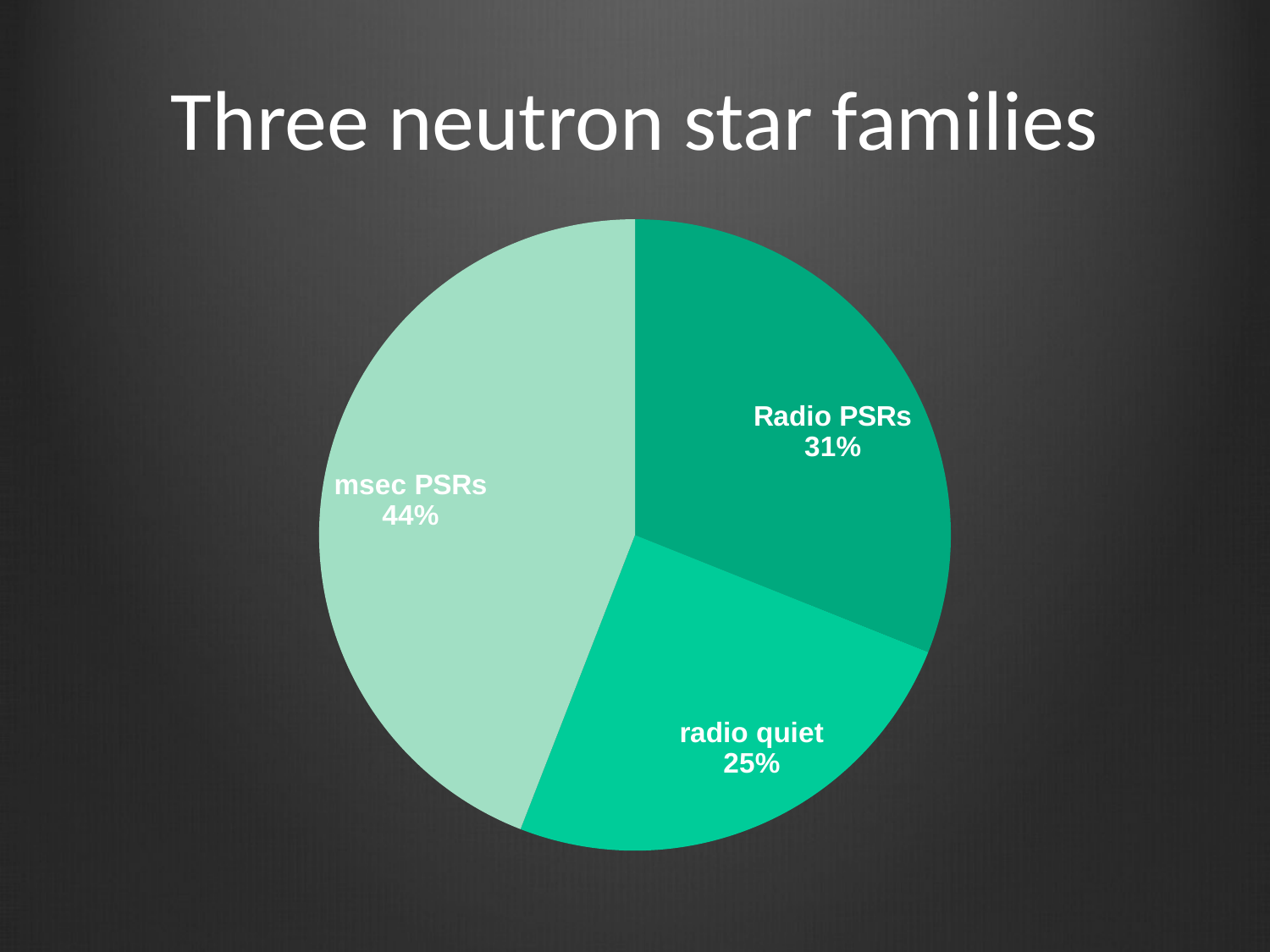
What share of the pie is labelled for radio quiet? 25% What is the difference in percentage points between the Radio PSRs slice and the radio quiet slice? 6 Which category has the largest slice of the pie? msec PSRs What share of the pie is labelled for msec PSRs? 44% Which category has the smallest slice of the pie? radio quiet What share of the pie is labelled for Radio PSRs? 31% Which slice is larger, Radio PSRs or radio quiet? Radio PSRs What kind of chart is shown on the slide? pie chart Which slice is larger, msec PSRs or Radio PSRs? msec PSRs How many slices does the pie chart have? 3 What is the difference in percentage points between the msec PSRs slice and the radio quiet slice? 19 What is the title of the slide containing the chart? Three neutron star families